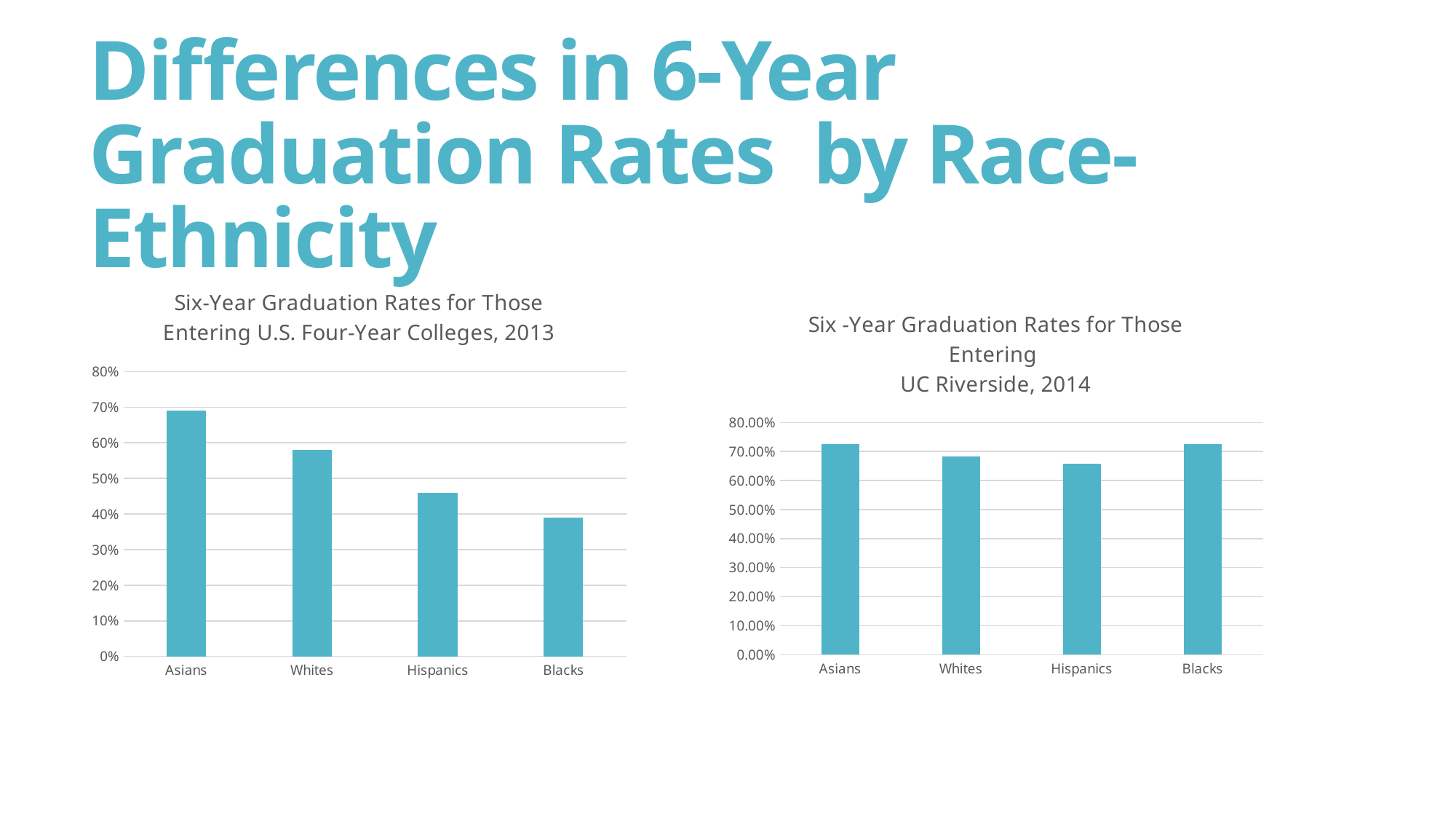
In the left chart (U.S. Four-Year Colleges, 2013), is the value for Whites greater or less than 50%? greater In the left chart (U.S. Four-Year Colleges, 2013), is the value for Hispanics greater or less than 50%? less In the left chart (U.S. Four-Year Colleges, 2013), which category has the highest graduation rate? Asians What kind of chart is the left chart, 'Six-Year Graduation Rates for Those Entering U.S. Four-Year Colleges, 2013'? bar chart In the right chart (UC Riverside, 2014), is the value for Hispanics greater or less than 60.00%? greater In the right chart (UC Riverside, 2014), which is larger, the value for Blacks or the value for Hispanics? Blacks In the left chart (U.S. Four-Year Colleges, 2013), do the values rise or fall moving from Asians to Blacks along the x axis? fall In the left chart (U.S. Four-Year Colleges, 2013), which category has the lowest graduation rate? Blacks What is the title of the right chart? Six -Year Graduation Rates for Those Entering UC Riverside, 2014 How many categories are shown on the x axis of the right chart, 'Six-Year Graduation Rates for Those Entering UC Riverside, 2014'? 4